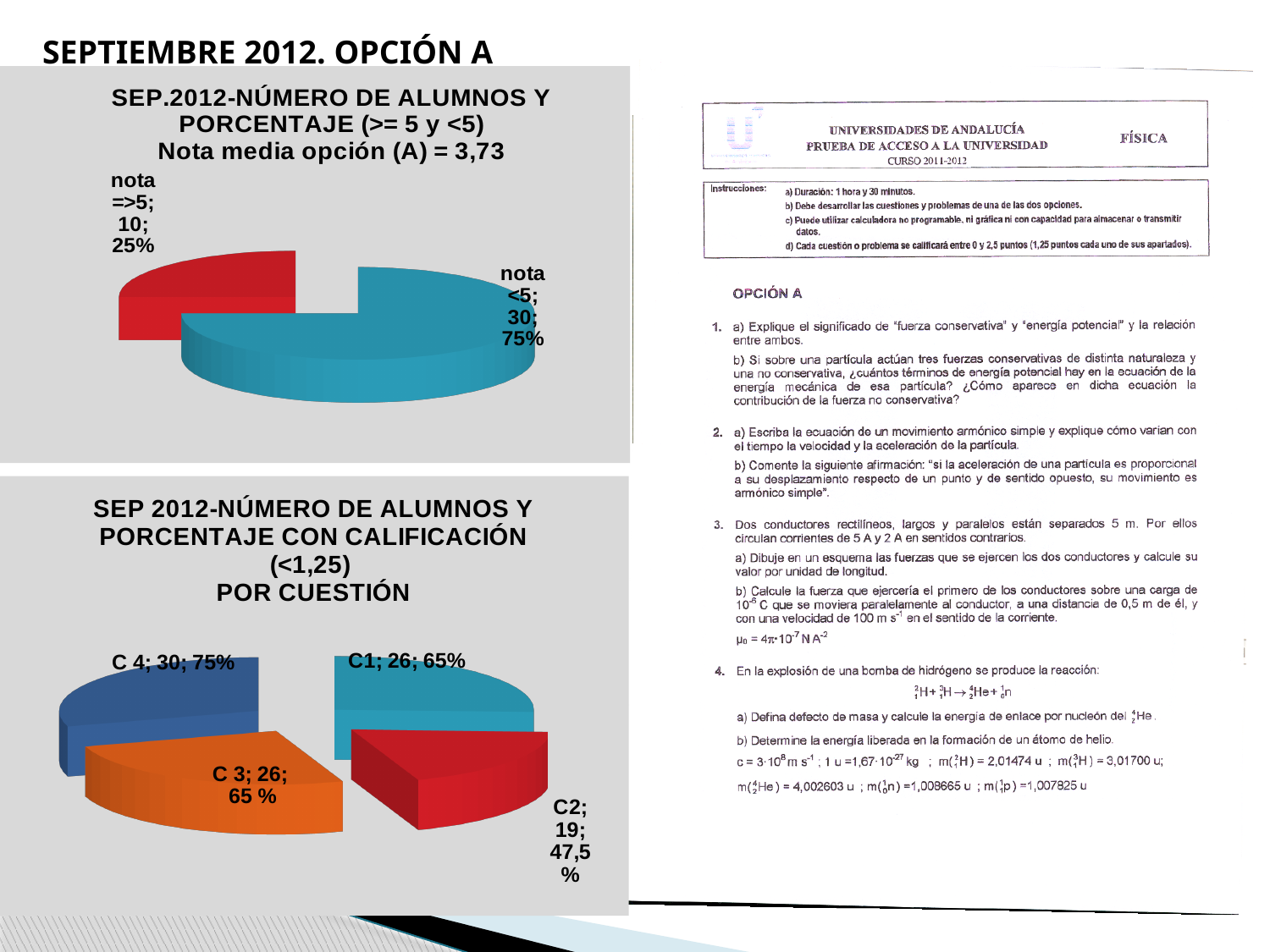
In the top chart (SEP.2012-NÚMERO DE ALUMNOS Y PORCENTAJE (>= 5 y <5)), how many slices does the pie have? 2 According to the top chart's title, what is the 'Nota media opción (A)'? 3,73 In the bottom chart (SEP 2012-NÚMERO DE ALUMNOS Y PORCENTAJE CON CALIFICACIÓN (<1,25) POR CUESTIÓN), which cuestión has the lowest number of students? C2 In the top chart (SEP.2012-NÚMERO DE ALUMNOS Y PORCENTAJE (>= 5 y <5)), which slice is larger, 'nota =>5' or 'nota <5'? nota <5 In the bottom chart (SEP 2012-NÚMERO DE ALUMNOS Y PORCENTAJE CON CALIFICACIÓN (<1,25) POR CUESTIÓN), what percentage is shown for C 4? 75% In the bottom chart (SEP 2012-NÚMERO DE ALUMNOS Y PORCENTAJE CON CALIFICACIÓN (<1,25) POR CUESTIÓN), what is the difference in number of students between C 4 and C2? 11 In the top chart (SEP.2012-NÚMERO DE ALUMNOS Y PORCENTAJE (>= 5 y <5)), what percentage is shown for 'nota =>5'? 25% In the bottom chart (SEP 2012-NÚMERO DE ALUMNOS Y PORCENTAJE CON CALIFICACIÓN (<1,25) POR CUESTIÓN), which cuestión has the highest number of students? C 4 In the bottom chart (SEP 2012-NÚMERO DE ALUMNOS Y PORCENTAJE CON CALIFICACIÓN (<1,25) POR CUESTIÓN), how many cuestiones (slices) are shown? 4 In the bottom chart (SEP 2012-NÚMERO DE ALUMNOS Y PORCENTAJE CON CALIFICACIÓN (<1,25) POR CUESTIÓN), how many students are shown for C2? 19 What type of chart is the top chart on the slide? Pie chart In the top chart (SEP.2012-NÚMERO DE ALUMNOS Y PORCENTAJE (>= 5 y <5)), how many students are in the 'nota <5' slice? 30